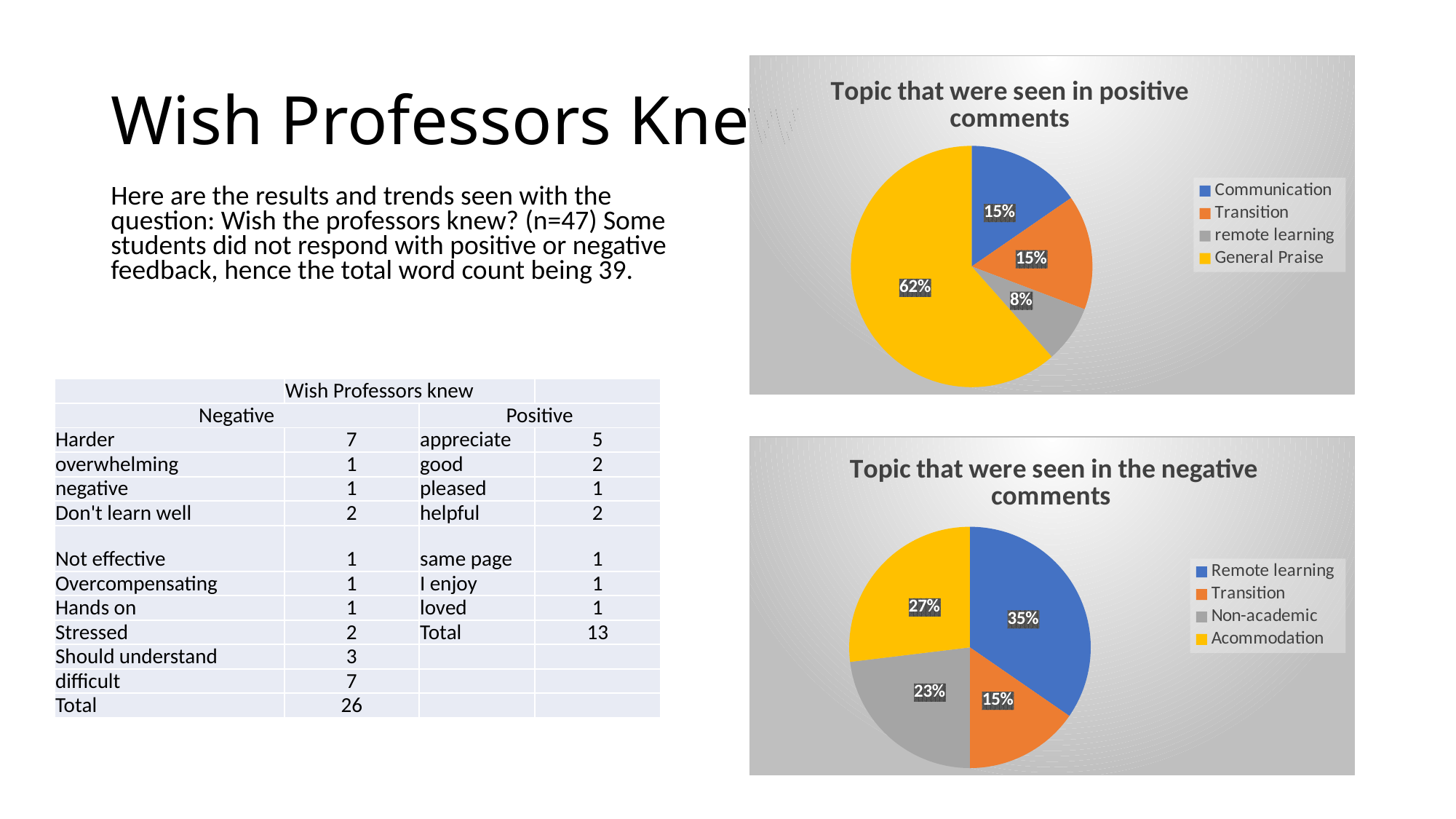
In the 'Topic that were seen in the negative comments' chart, which topic has the smallest slice? Transition In the 'Topic that were seen in the negative comments' chart, what is the difference in percentage points between Remote learning and Acommodation? 8 In the 'Topic that were seen in positive comments' chart, which topic has the largest slice? General Praise In the 'Topic that were seen in the negative comments' chart, which topic has the largest slice? Remote learning In the 'Topic that were seen in the negative comments' chart, what share does Remote learning have? 35% In the 'Topic that were seen in positive comments' chart, how many topics does the legend list? 4 In the 'Topic that were seen in the negative comments' chart, which is larger, Non-academic or Acommodation? Acommodation In the 'Topic that were seen in positive comments' chart, what share does General Praise have? 62% In the 'Topic that were seen in positive comments' chart, which topic has the smallest slice? remote learning In the 'Topic that were seen in the negative comments' chart, what share does Non-academic have? 23% What kind of chart is 'Topic that were seen in the negative comments'? Pie chart